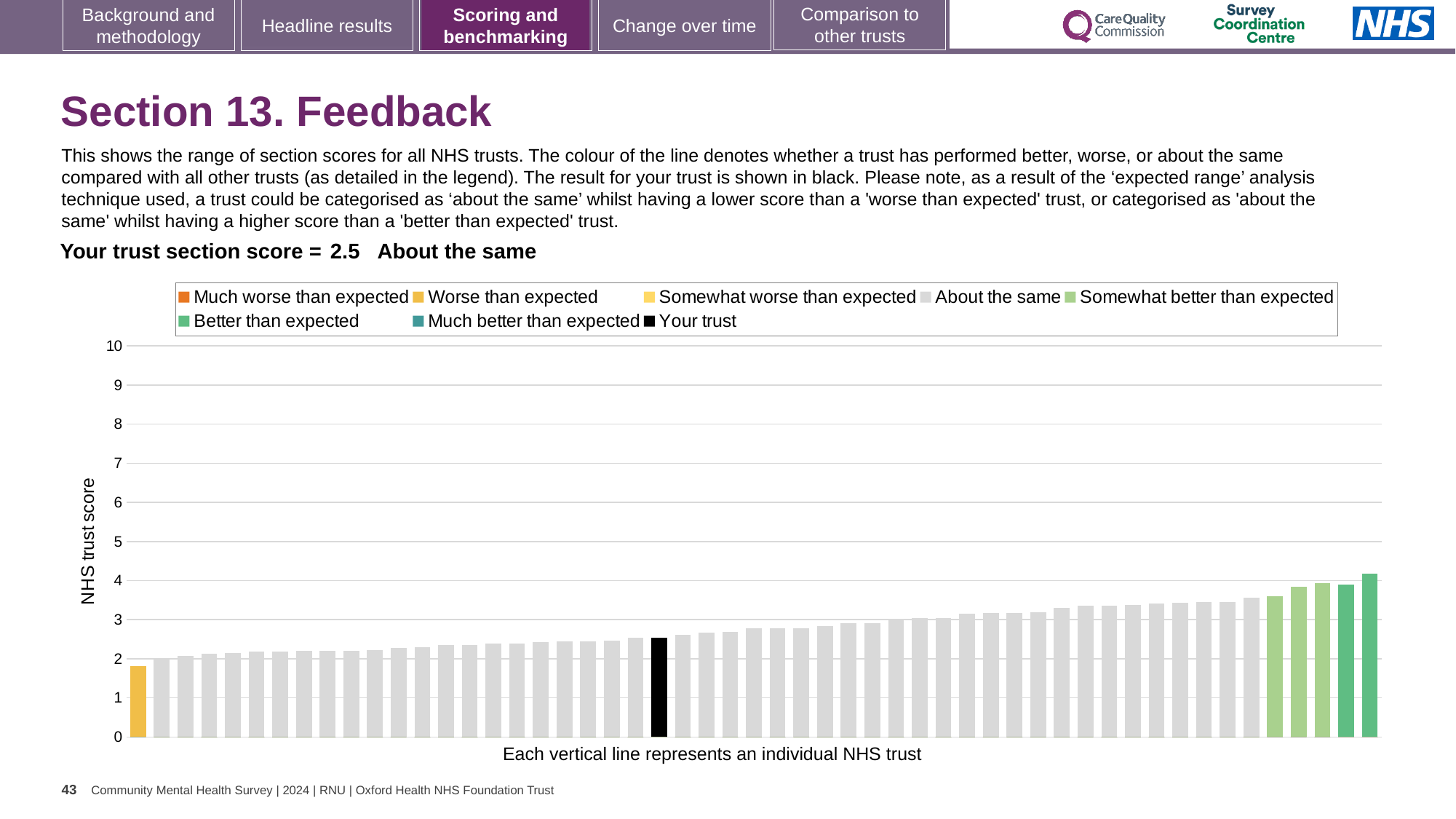
How is your trust categorised compared with other trusts, according to the slide? About the same What is the label on the vertical axis? NHS trust score What is the section score for your trust shown on the slide? 2.5 Which legend category does the tallest bar belong to? Better than expected What kind of chart is shown on the slide? bar chart How many entries does the chart legend list? 8 Is the black bar for your trust higher or lower than the leftmost bar? higher Do the bar values rise or fall from left to right along the x axis? rise Is the value of the tallest bar greater or less than 4? greater Is the value for your trust (the black bar) greater or less than 5? less Is the value of the leftmost bar greater or less than 2? less